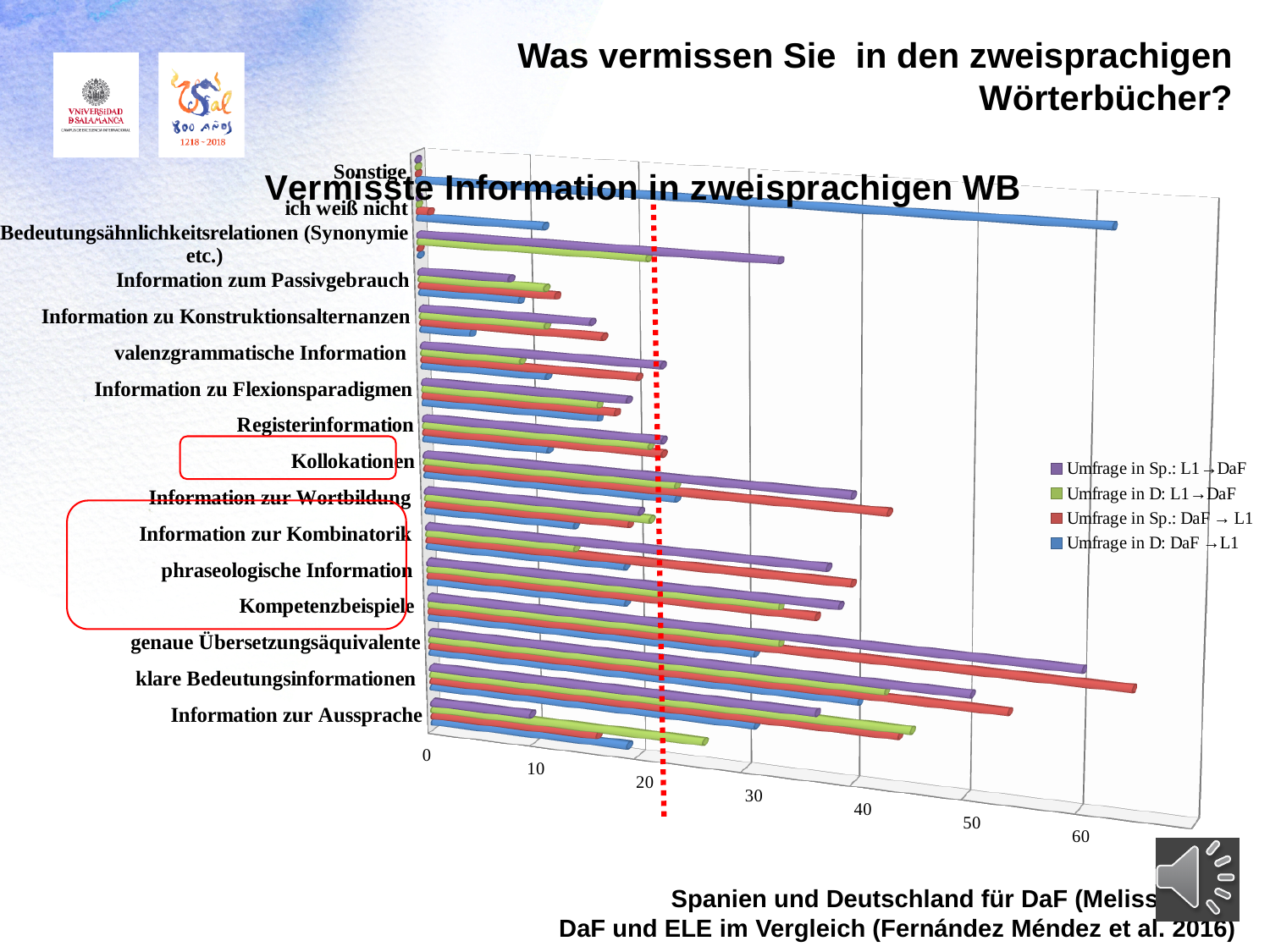
Which colour represents the series 'Umfrage in D: DaF →L1' in the chart? blue What kind of chart is shown on the slide? bar chart Is the value for 'klare Bedeutungsinformationen' in the series 'Umfrage in Sp.: DaF → L1' greater or less than 50? less Is the value for 'ich weiß nicht' in the series 'Umfrage in D: DaF →L1' greater or less than 50? less Is the value for 'Bedeutungsähnlichkeitsrelationen (Synonymie etc.)' in the series 'Umfrage in Sp.: L1→DaF' greater or less than 20? greater What is the title of the chart? Vermisste Information in zweisprachigen WB For 'ich weiß nicht', which series has the larger value: 'Umfrage in D: DaF →L1' or 'Umfrage in Sp.: L1→DaF'? Umfrage in D: DaF →L1 How many categories are shown on the chart's vertical axis? 16 How many series does the chart legend list? 4 Which category has the highest value in the series 'Umfrage in D: DaF →L1'? Sonstige